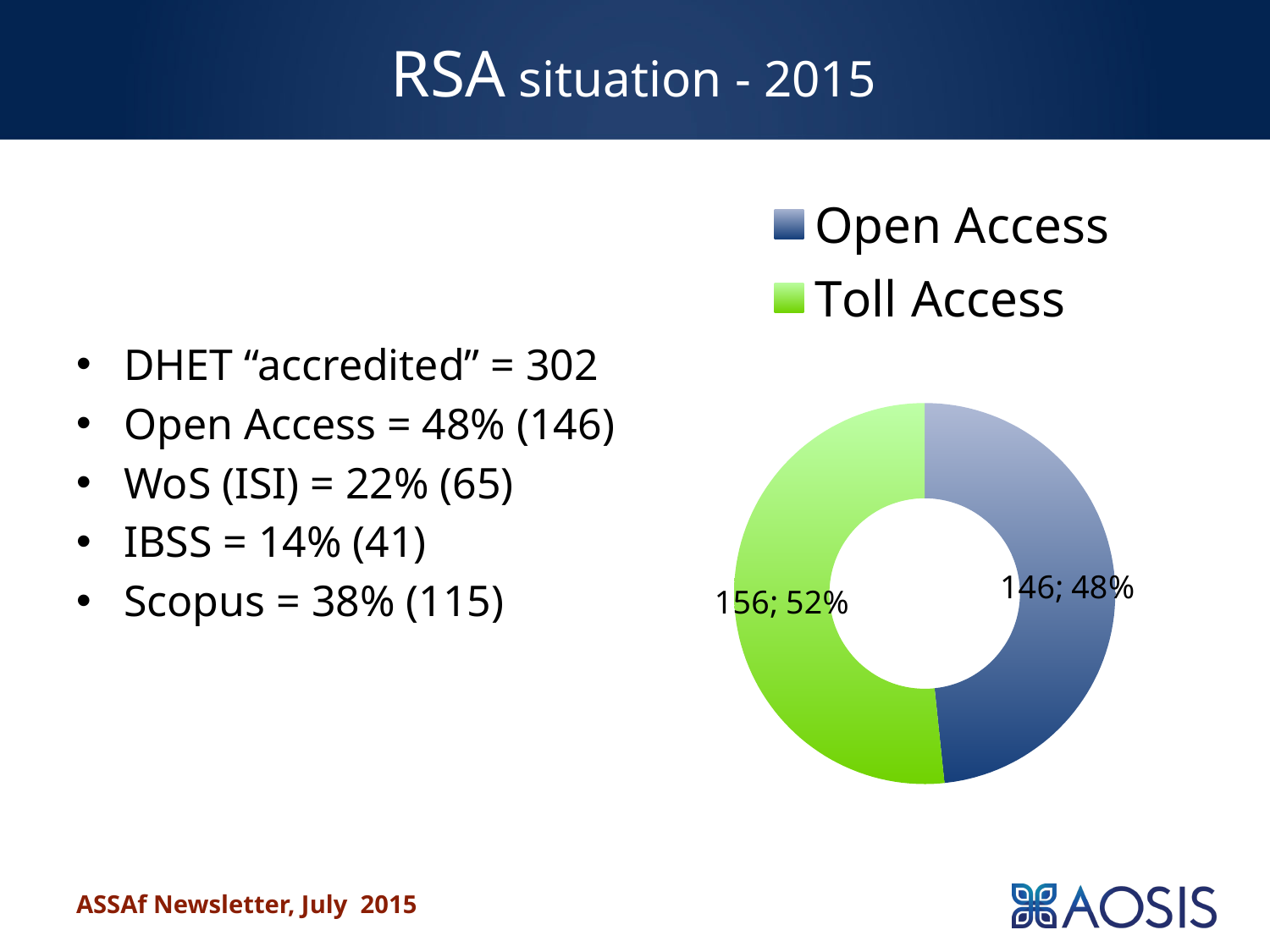
What is the difference between the Toll Access and Open Access values? 10 Which colour represents Toll Access in the chart? Green What is the value shown for Toll Access? 156 How many categories does the chart show? 2 What is the value shown for Open Access? 146 Which category has the smallest share of the chart? Open Access What percentage share does Open Access have? 48% What percentage share does Toll Access have? 52% Which category has the larger value, Open Access or Toll Access? Toll Access What is the total of the two values shown on the chart? 302 How many entries does the legend list? 2 What kind of chart is shown on the slide? Doughnut (pie) chart